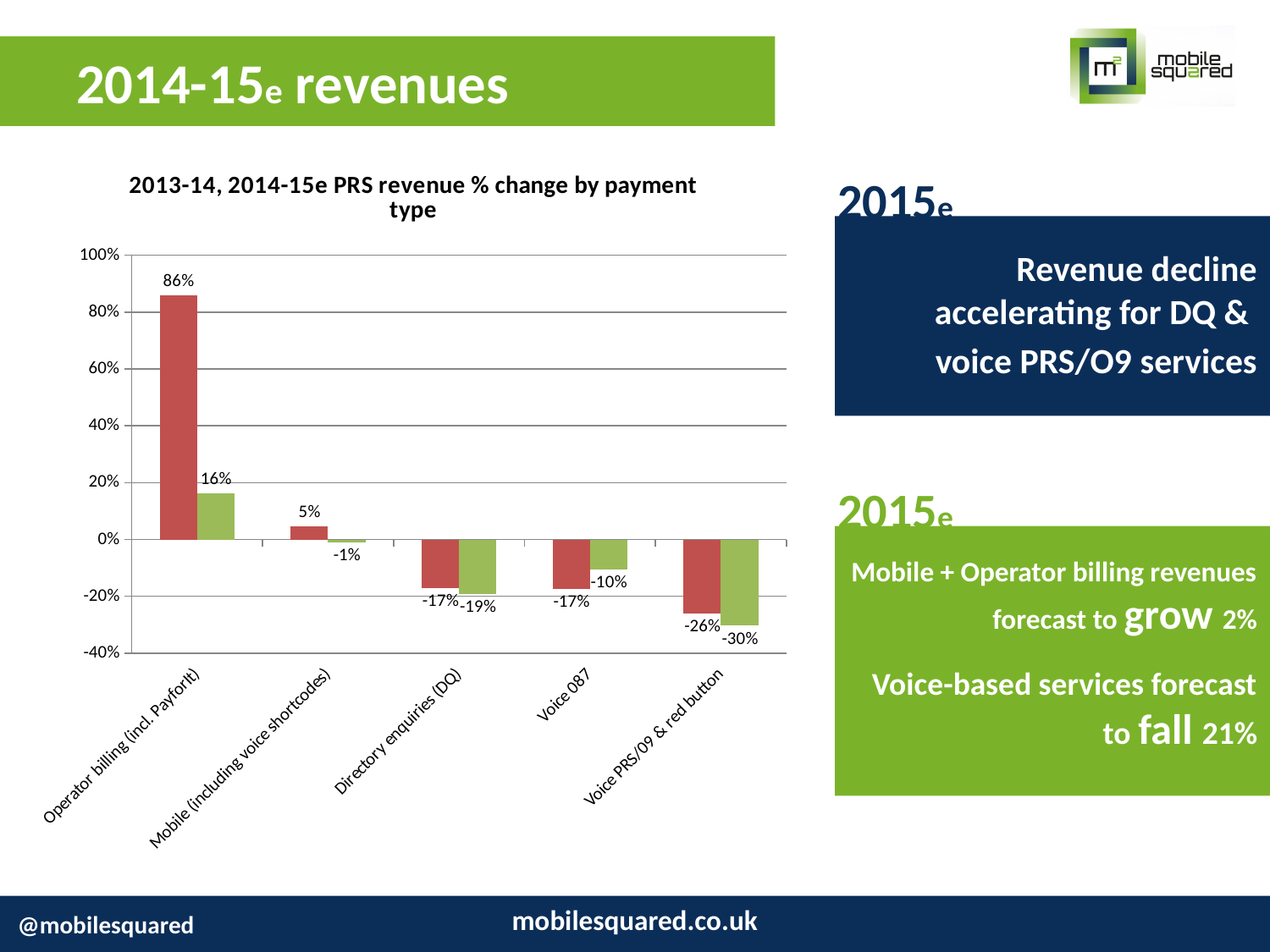
What is the value of the green bar for Voice PRS/09 & red button? -30% How many payment type categories are shown on the x axis of the chart? 5 Which category has the lowest green bar value? Voice PRS/09 & red button Is the red bar value for Operator billing (incl. PayforIt) greater or less than 80%? greater What is the value of the green bar for Mobile (including voice shortcodes)? -1% What is the value of the green bar for Operator billing (incl. PayforIt)? 16% For Voice 087, which is larger, the red bar value or the green bar value? the green bar (-10%) What kind of chart is shown on the slide? bar chart Which category has the highest red bar value? Operator billing (incl. PayforIt) What is the difference between the red bar and the green bar for Operator billing (incl. PayforIt)? 70 percentage points What is the title of the chart? 2013-14, 2014-15e PRS revenue % change by payment type What is the value of the red bar for Operator billing (incl. PayforIt)? 86%